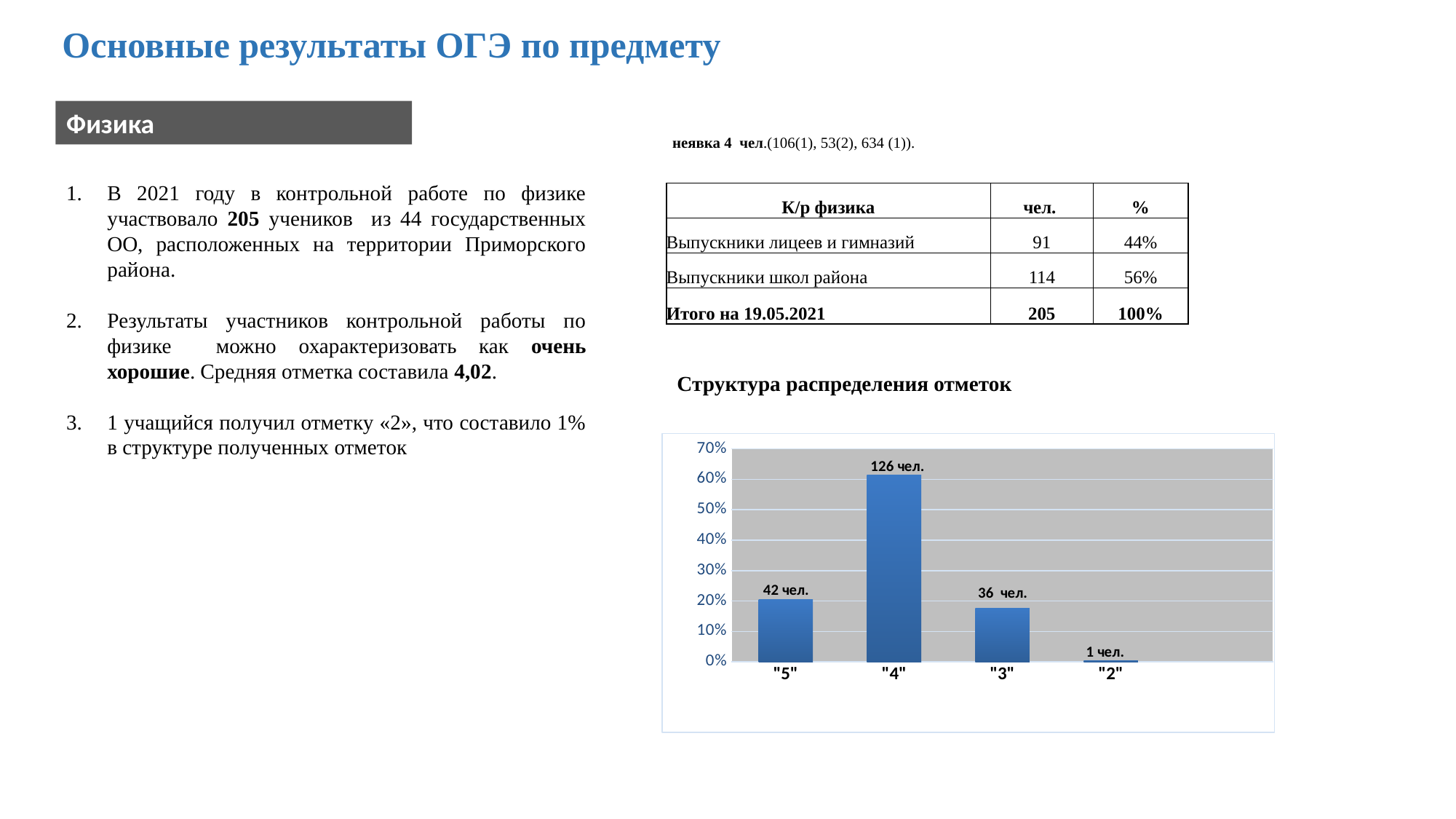
Is the value for "4" greater or less than 50%? greater What is the data label for the "2" bar in the chart? 1 чел. Which bar is larger, "5" or "3"? "5" What is the title of the chart? Структура распределения отметок By how many people does the "4" bar exceed the "5" bar, according to the data labels? 84 чел. Which grade category has the highest bar in the chart? "4" What kind of chart is shown on the slide? bar chart What is the data label for the "5" bar in the chart? 42 чел. What is the data label for the "4" bar in the chart? 126 чел. Which grade category has the lowest bar in the chart? "2" What is the data label for the "3" bar in the chart? 36 чел. How many grade categories are shown on the x axis of the chart? 4